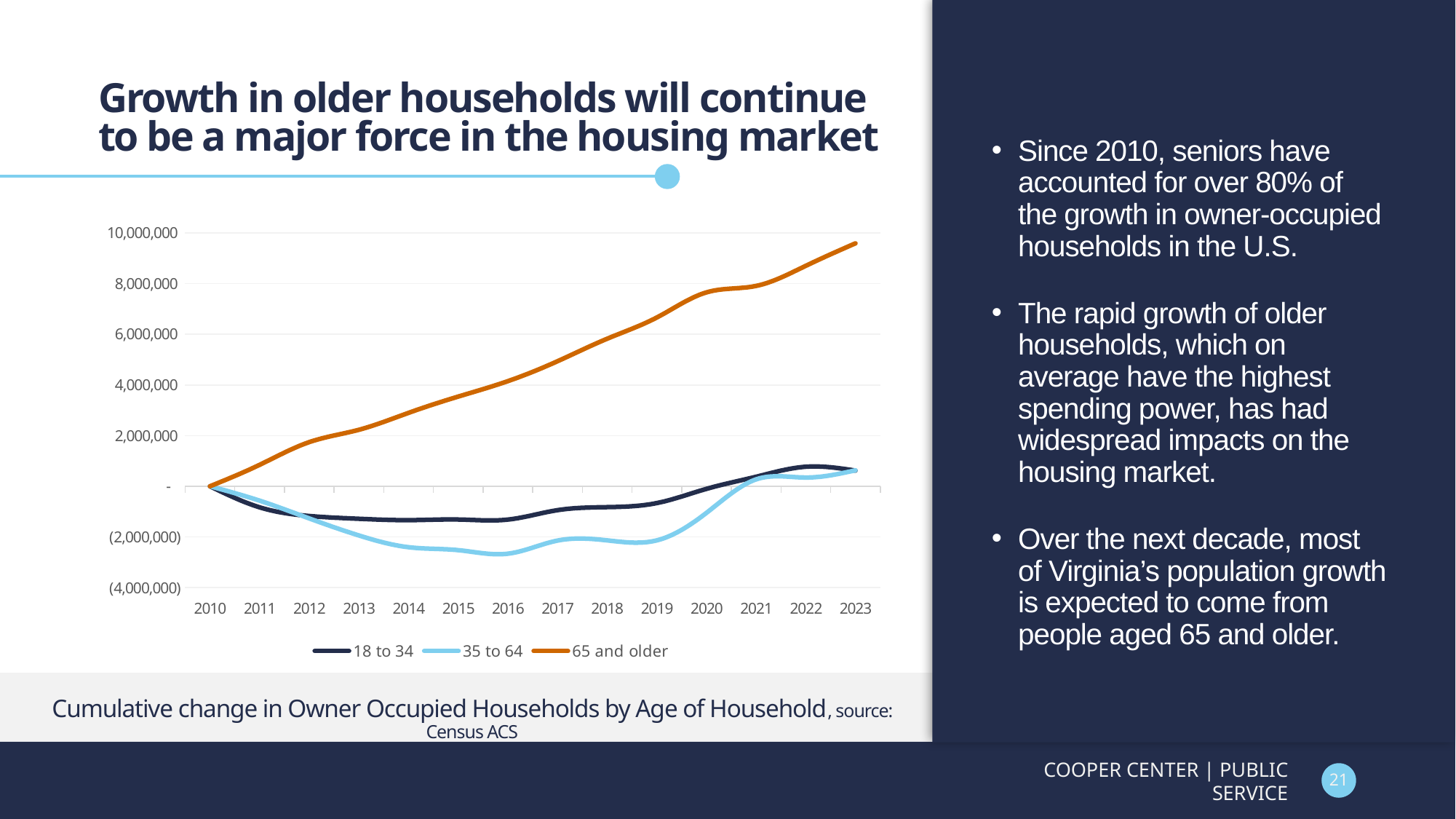
Is the value for 65 and older in 2023 greater or less than 8,000,000? greater What kind of chart is shown on the slide? line chart How many series does the chart legend list? 3 How many years are shown along the x axis of the chart? 14 What colour is the line for 65 and older? orange Which age group has the lowest cumulative change in 2016? 35 to 64 Is the value for 65 and older in 2019 greater or less than 6,000,000? greater Is the value for 35 to 64 in 2016 greater or less than (2,000,000)? less Does the 35 to 64 line rise or fall from 2010 to 2016? fall Does the 65 and older line rise or fall from 2010 to 2023? rise Which age group has the highest cumulative change in 2023? 65 and older In 2020, which is larger: the value for 18 to 34 or the value for 35 to 64? 18 to 34